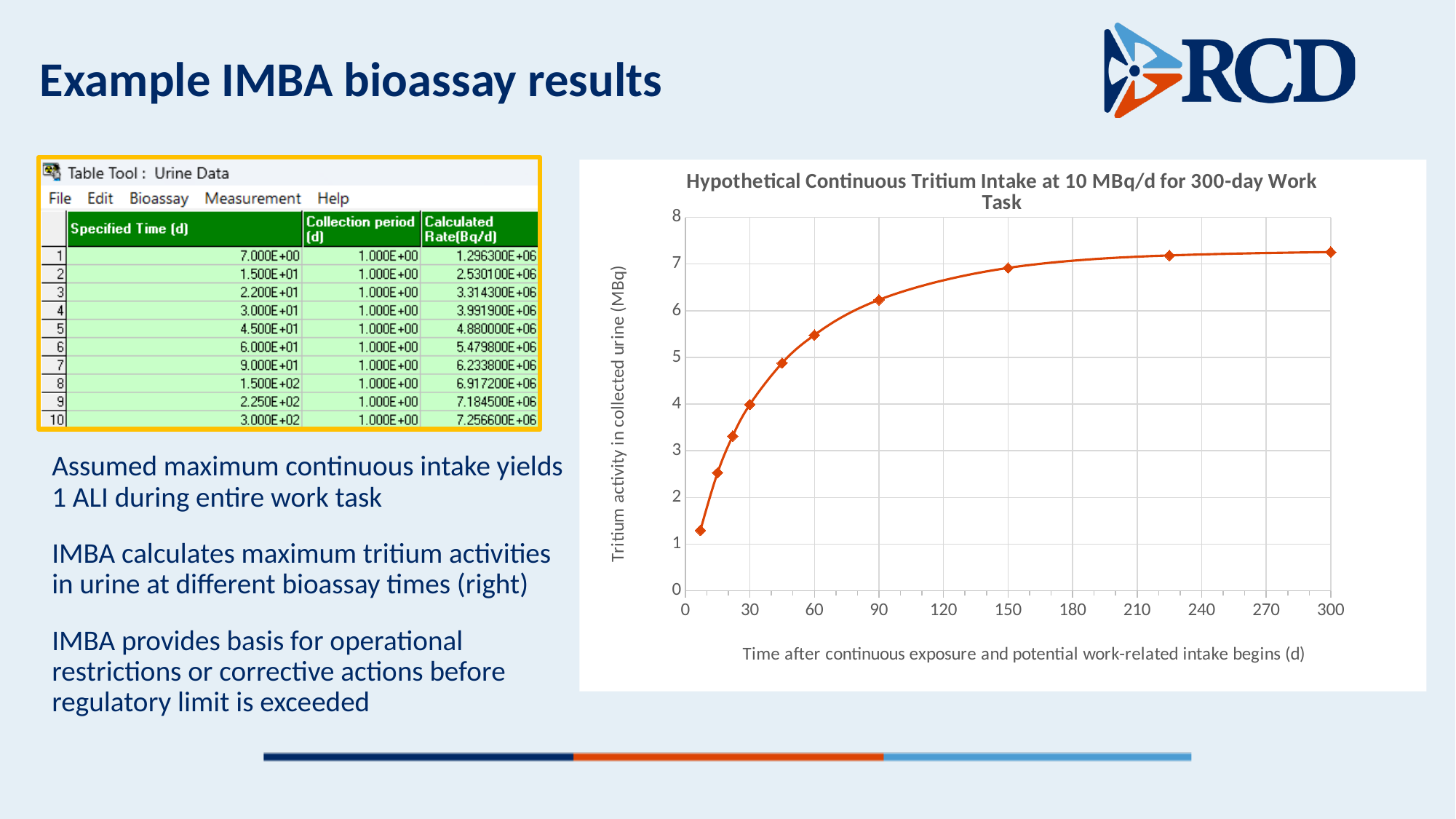
What kind of chart is shown on the slide? line chart Is the value at 15 days greater or less than 3? less Which has the larger value, the point at 60 days or the point at 90 days? 90 days Is the value at 60 days greater or less than 5? greater Is the value at 300 days greater or less than 7? greater How many data points are plotted on the chart? 10 What is the label of the y axis of the chart? Tritium activity in collected urine (MBq) What is the title of the chart? Hypothetical Continuous Tritium Intake at 10 MBq/d for 300-day Work Task Do the values on the chart rise or fall as time increases along the x axis? rise At which time on the x axis is the plotted tritium activity highest? 300